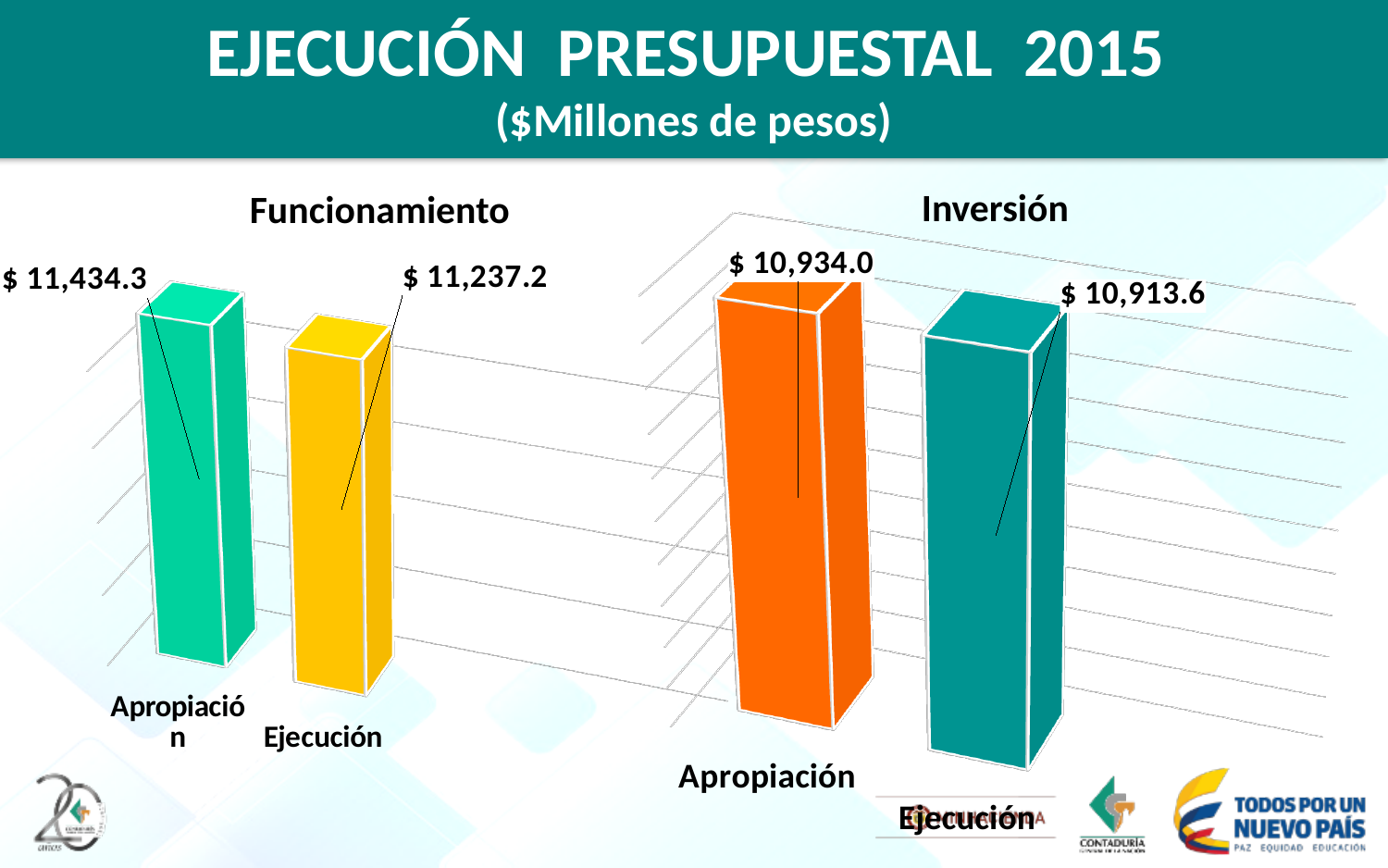
What unit is stated in the slide title for the values shown? $Millones de pesos In the Funcionamiento chart, what is the value for Apropiación? $ 11,434.3 In the Inversión chart, what is the difference between Apropiación and Ejecución? $ 20.4 How many bars are shown in the Inversión chart? 2 In the Funcionamiento chart, what is the value for Ejecución? $ 11,237.2 In the Funcionamiento chart, which category has the higher value? Apropiación What kind of chart is the Funcionamiento chart? bar chart Is the Apropiación value in the Funcionamiento chart larger or smaller than the Apropiación value in the Inversión chart? larger In the Funcionamiento chart, what is the difference between Apropiación and Ejecución? $ 197.1 In the Inversión chart, what is the value for Apropiación? $ 10,934.0 In the Inversión chart, which category has the lower value? Ejecución In the Inversión chart, what is the value for Ejecución? $ 10,913.6